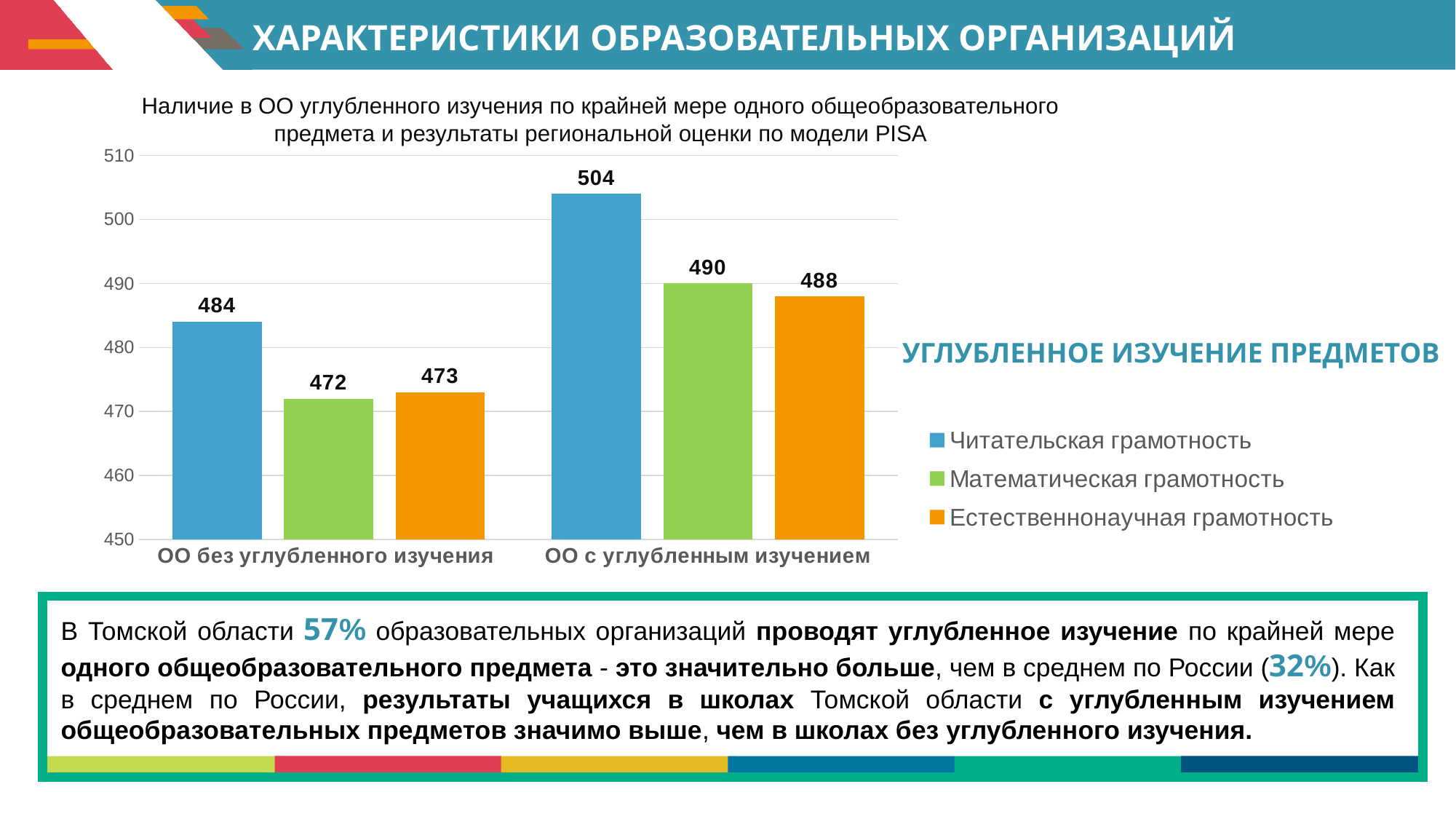
Which series has the highest value for ОО без углубленного изучения? Читательская грамотность What is the value of Математическая грамотность for ОО без углубленного изучения? 472 How many series does the legend list? 3 Which is larger: Математическая грамотность for ОО с углубленным изучением or Естественнонаучная грамотность for ОО без углубленного изучения? Математическая грамотность for ОО с углубленным изучением Which colour represents Естественнонаучная грамотность in the legend? orange What is the difference between Читательская грамотность for ОО с углубленным изучением and for ОО без углубленного изучения? 20 What kind of chart is shown on the slide? bar chart What is the value of Естественнонаучная грамотность for ОО с углубленным изучением? 488 Is the value of Читательская грамотность for ОО с углубленным изучением greater or less than 500? greater What is the value of Читательская грамотность for ОО с углубленным изучением? 504 Which series has the lowest value for ОО с углубленным изучением? Естественнонаучная грамотность How many categories are shown on the x axis? 2